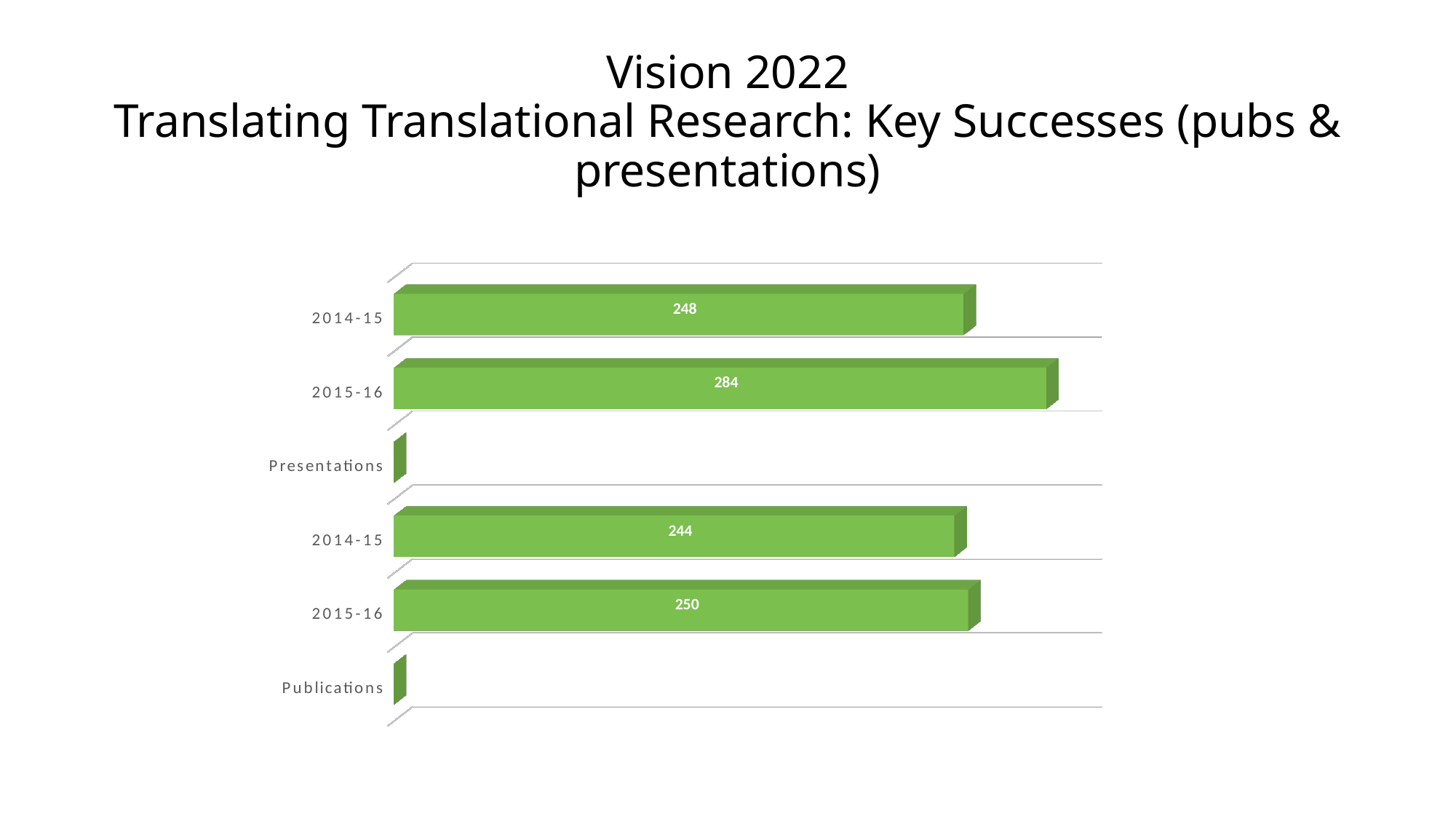
What is the difference between the 2015-16 and 2014-15 bars in the Publications group (250 and 244)? 6 What is the value of the 2015-16 bar in the Publications group (fifth bar from the top)? 250 Which is larger: the 2015-16 bar in the Presentations group or the 2015-16 bar in the Publications group? 2015-16 in the Presentations group (284) What is the value of the 2015-16 bar in the Presentations group (second bar from the top)? 284 What colour are the bars in the chart? green Among the four bars with data labels, which has the lowest value? 2014-15 (Publications group, 244) What is the difference between the 2015-16 and 2014-15 bars in the Presentations group (284 and 248)? 36 What is the value of the 2014-15 bar in the Publications group (fourth bar from the top)? 244 Which labelled bar has the highest value? 2015-16 (Presentations group, 284) What is the value of the topmost 2014-15 bar (the one above the Presentations label)? 248 How many bars with printed data labels are there on the chart? 4 What kind of chart is shown on the slide? bar chart